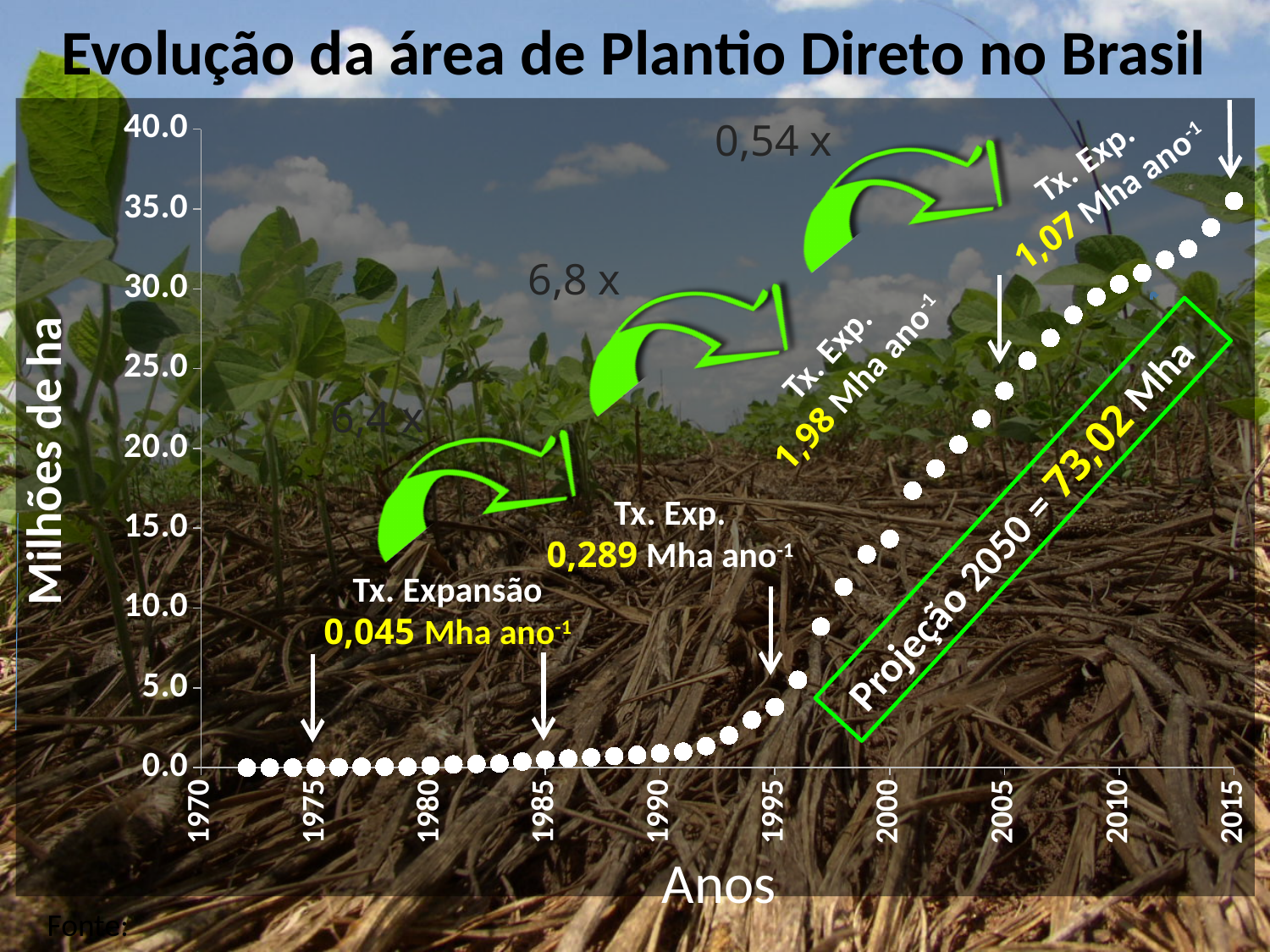
Is the value for 1995 greater or less than 10.0? less What is the title of the chart? Evolução da área de Plantio Direto no Brasil Which year has the highest plotted value? 2015 What kind of chart is shown on the slide? scatter chart Is the value for 2005 greater or less than 20.0? greater Is the value for 2000 greater or less than 10.0? greater What projected value for 2050 is shown on the chart? 73,02 Mha What expansion rate (Tx. Expansão) is annotated at 1975? 0,045 Mha ano-1 Do the plotted values rise or fall from 1970 to 2015? rise Which is larger, the value for 2005 or the value for 1995? 2005 What is the label of the y axis? Milhões de ha